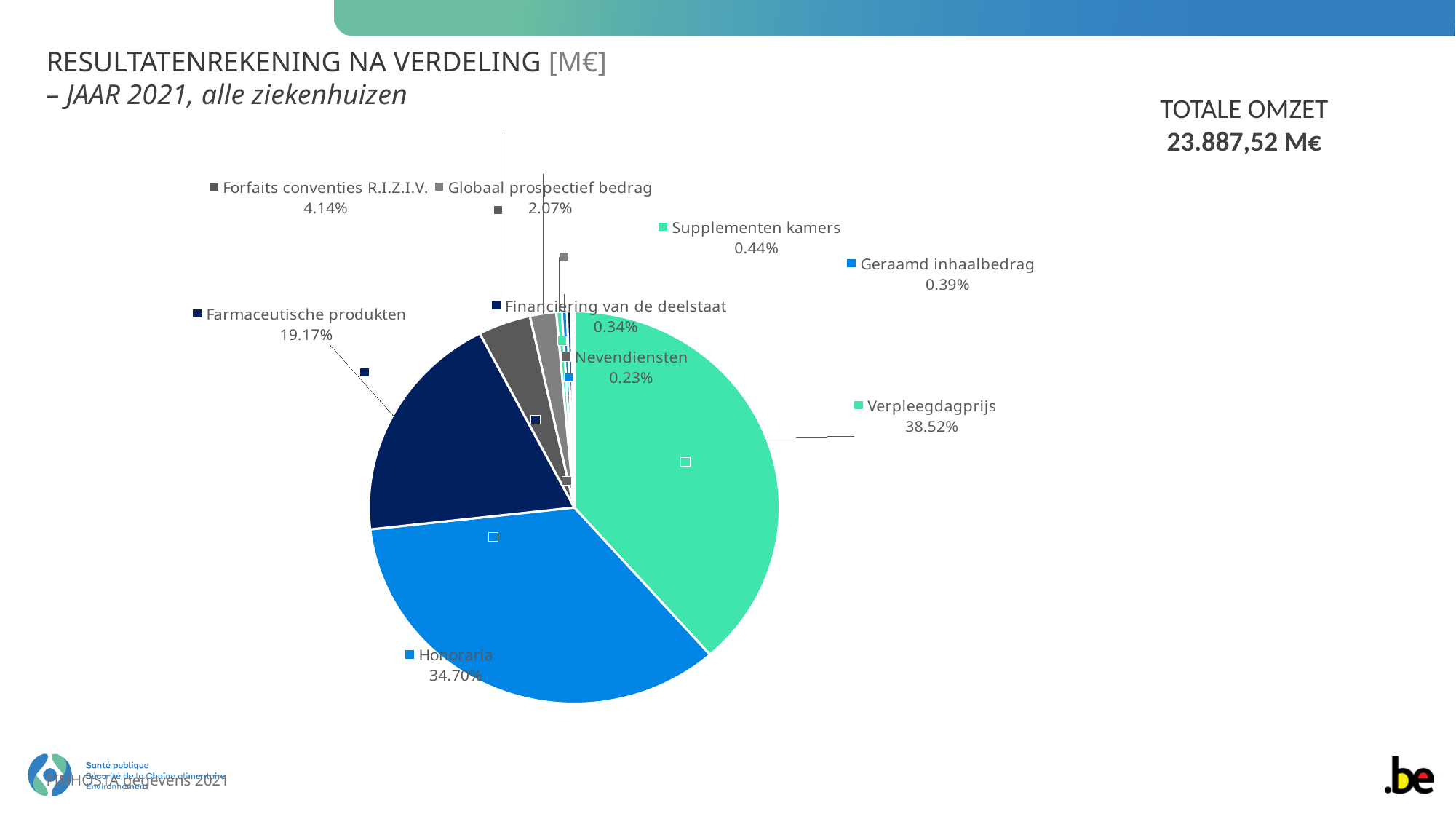
What share of the pie does Verpleegdagprijs represent? 38.52% What is the value shown for Farmaceutische produkten? 19.17% What is the value shown for Globaal prospectief bedrag? 2.07% What kind of chart is shown on the slide? pie chart Which category has the largest share of the pie? Verpleegdagprijs What is the value shown for Forfaits conventies R.I.Z.I.V.? 4.14% Which category has the smallest share of the pie? Nevendiensten How many categories are shown in the pie chart? 9 Which is larger, the share for Supplementen kamers or the share for Geraamd inhaalbedrag? Supplementen kamers What is the value shown for Honoraria? 34.70% What is the value shown for Nevendiensten? 0.23% What is the difference in percentage points between Verpleegdagprijs and Honoraria? 3.82